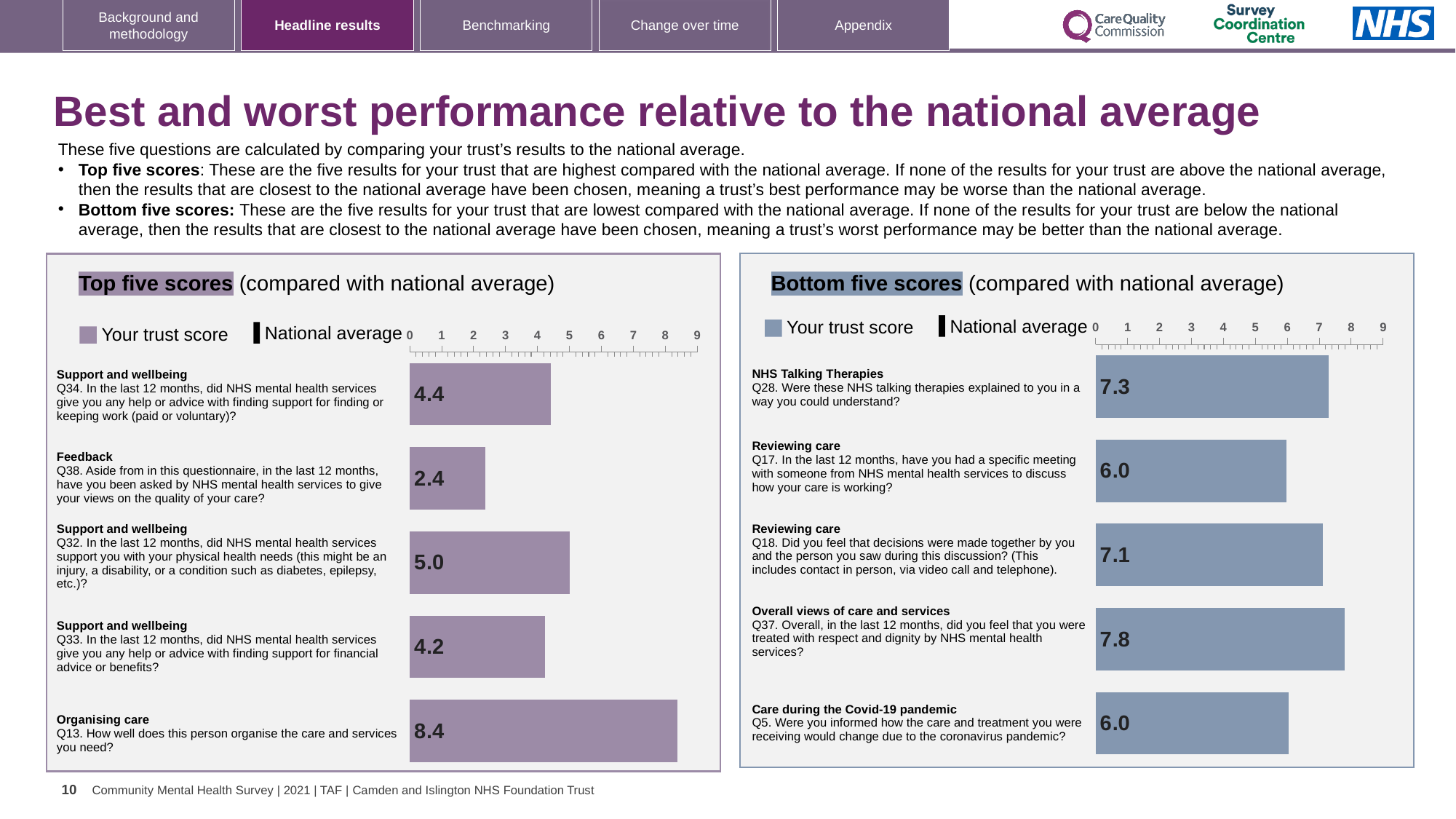
In the 'Top five scores' chart, which question has the highest trust score? Q13 (Organising care) In the 'Top five scores' chart, what is the trust score for Q38 (Feedback)? 2.4 In the 'Top five scores' chart, which question has the lowest trust score? Q38 (Feedback) In the 'Bottom five scores' chart, what is the difference between the trust scores for Q37 and Q17? 1.8 In the 'Bottom five scores' chart, what is the trust score for Q28 (NHS Talking Therapies)? 7.3 In the 'Top five scores' chart, what is the difference between the trust scores for Q13 and Q38? 6.0 In the 'Bottom five scores' chart, what is the trust score for Q37 (Overall views of care and services)? 7.8 In the 'Top five scores' chart, what is the trust score for Q13 (Organising care)? 8.4 In the 'Bottom five scores' chart, which has the larger trust score: Q28 or Q18? Q28 What type of chart is the 'Bottom five scores' chart? Bar chart How many questions are shown in the 'Top five scores' chart? 5 In the 'Bottom five scores' chart, which question has the highest trust score? Q37 (Overall views of care and services)